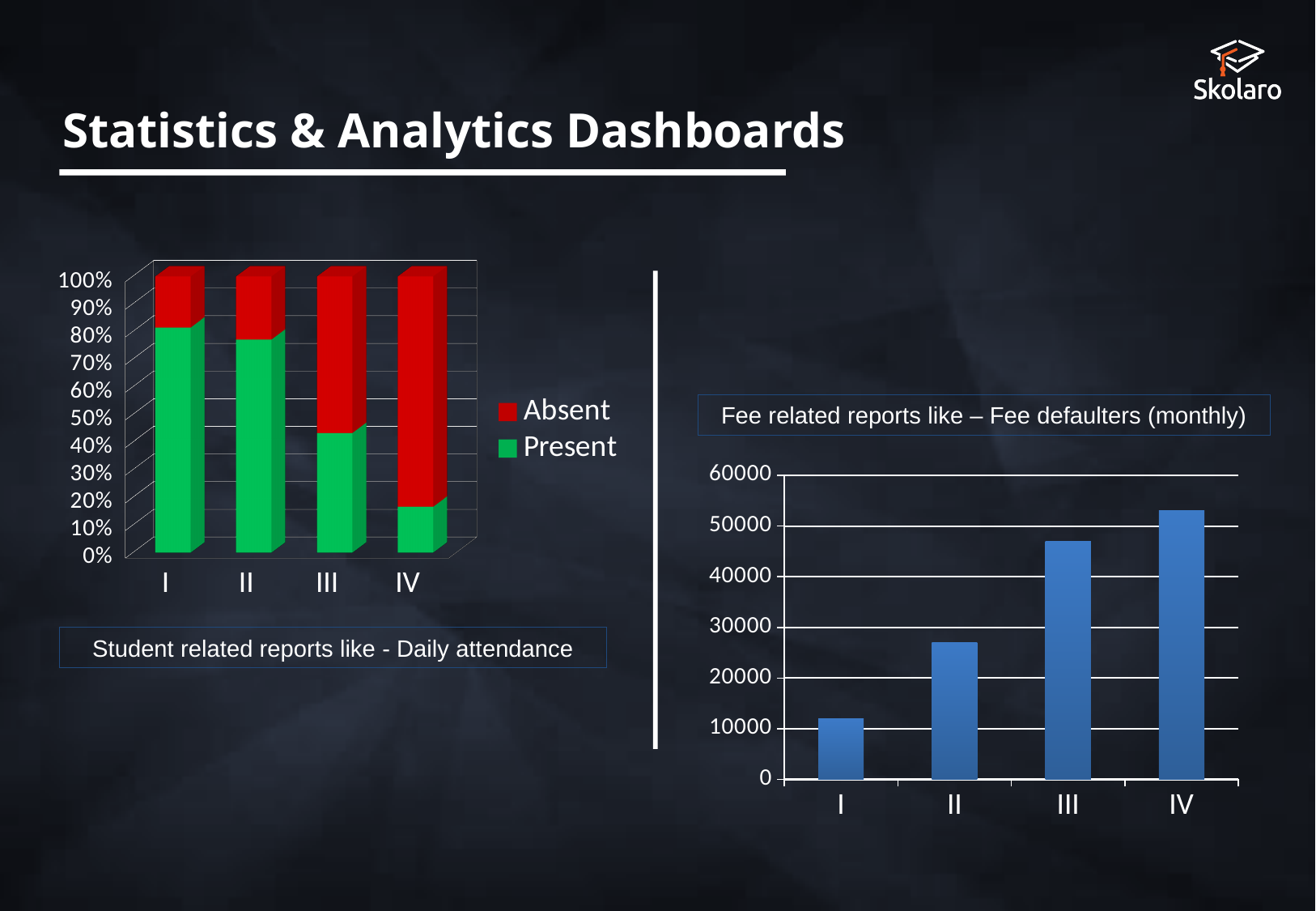
In the right chart (Fee related reports like – Fee defaulters (monthly)), which category has the lowest value? I In the left chart (Student related reports like - Daily attendance), how many categories are shown on the x axis? 4 In the left chart (Student related reports like - Daily attendance), which category has the lowest Present share? IV In the right chart (Fee related reports like – Fee defaulters (monthly)), do the values rise or fall from I to IV? rise In the right chart (Fee related reports like – Fee defaulters (monthly)), which category has the highest value? IV In the left chart (Student related reports like - Daily attendance), is the Present share for III greater or less than 50%? less In the left chart (Student related reports like - Daily attendance), does the Present share rise or fall from category I to category IV? fall In the right chart (Fee related reports like – Fee defaulters (monthly)), which is larger, the value for II or the value for III? III In the left chart (Student related reports like - Daily attendance), what kind of chart is shown? bar chart In the left chart (Student related reports like - Daily attendance), how many series does the legend list? 2 In the right chart (Fee related reports like – Fee defaulters (monthly)), is the value for III greater or less than 40000? greater In the left chart (Student related reports like - Daily attendance), is the Present share for I greater or less than 70%? greater